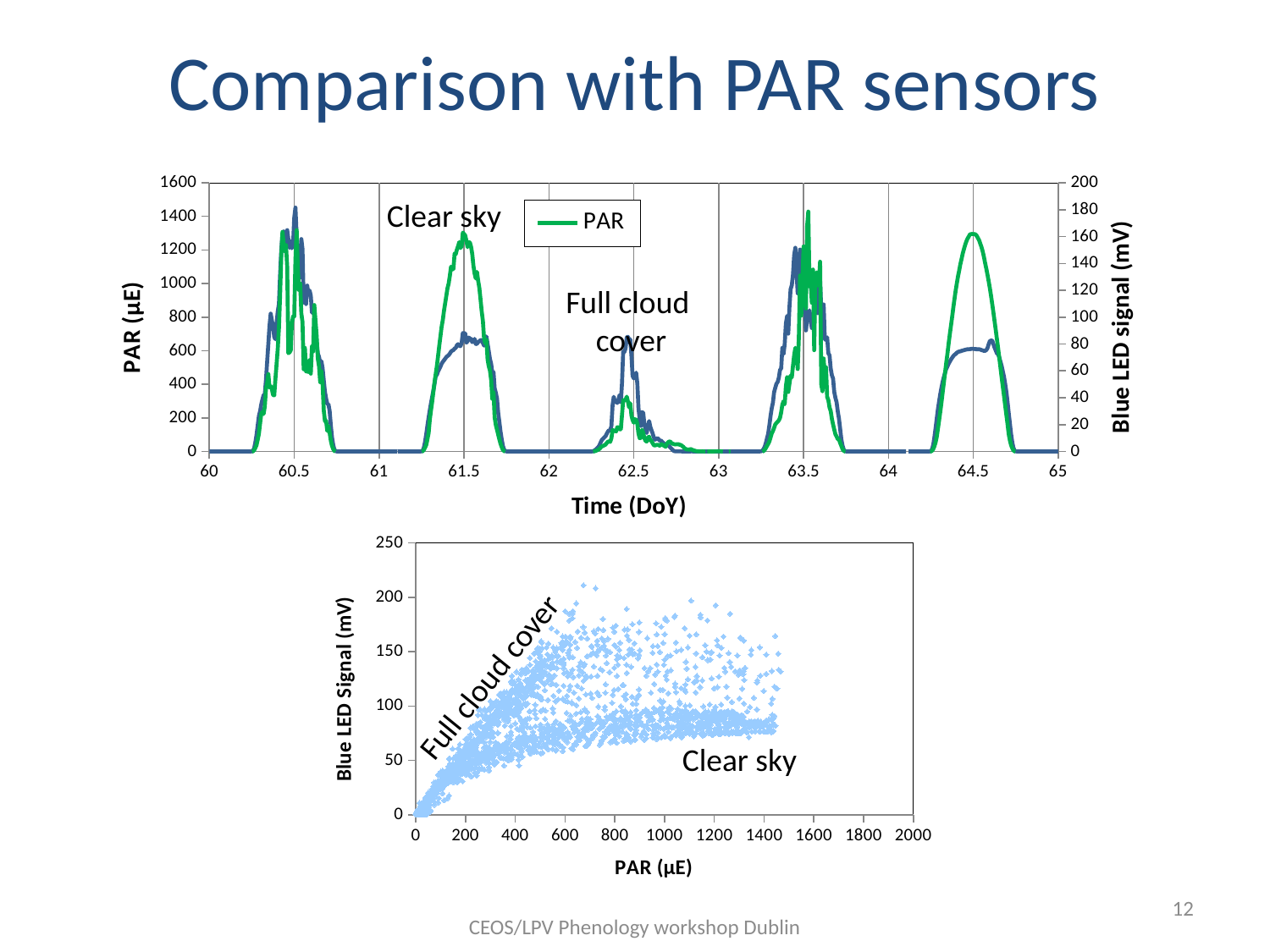
In the top chart, which day has the lower peak PAR: day 62.5 or day 64.5? 62.5 In the top chart, what is the label of the right-hand y axis? Blue LED signal (mV) In the top chart, is the peak PAR value on the 'Clear sky' day (around 61.5) greater or less than 1000? greater In the bottom chart, is the largest PAR value among the plotted points greater or less than 1600? less In the top chart, is the peak PAR value around day 64.5 greater or less than 1000? greater What kind of chart is the bottom chart (Blue LED Signal vs PAR)? scatter chart In the bottom chart, what is the label of the x axis? PAR (µE) What kind of chart is the top chart (PAR and Blue LED signal over time)? line chart In the top chart, how many daily peaks of PAR are plotted between day 60 and day 65? 5 In the top chart, how many series does the legend list? 1 In the top chart, what is the label of the x axis? Time (DoY)